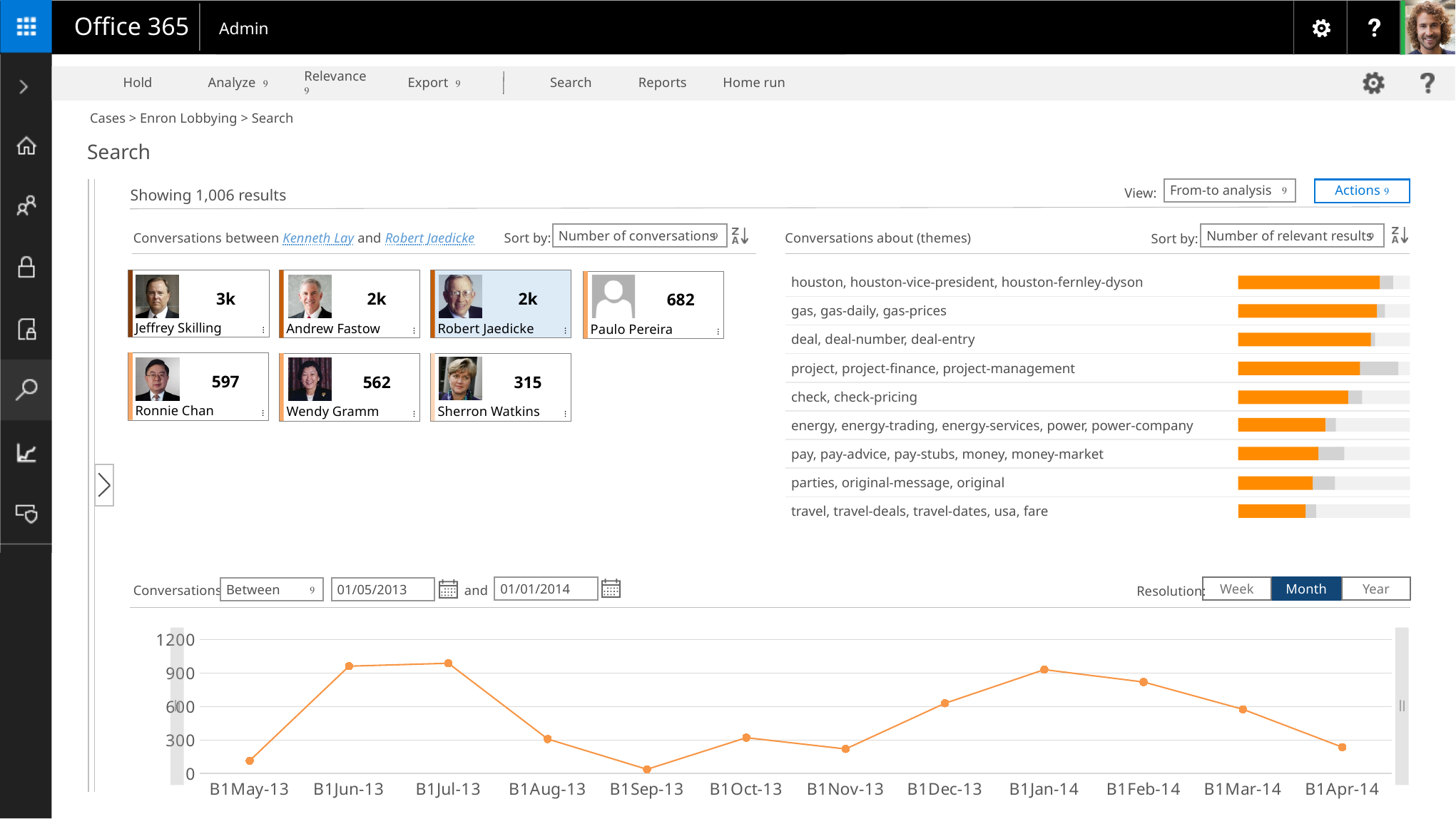
In the bottom line chart, which month has the lowest value? B1Sep-13 In the bottom line chart, do the values rise or fall from B1Jan-14 to B1Apr-14? fall In the bottom line chart, how many monthly data points are plotted? 12 What kind of chart is the chart at the bottom of the slide showing conversations by month? line chart In the 'Conversations about (themes)' chart, which theme has the shortest bar? travel, travel-deals, travel-dates, usa, fare In the bottom line chart, is the value for B1Feb-14 greater or less than 600? greater In the bottom line chart, is the value for B1Sep-13 greater or less than 300? less In the bottom line chart, is the value for B1Apr-14 greater or less than 300? less In the 'Conversations about (themes)' chart, how many theme categories are shown? 9 In the bottom line chart, do the values rise or fall from B1Nov-13 to B1Jan-14? rise In the bottom line chart, which is larger, the value for B1Jun-13 or the value for B1Aug-13? B1Jun-13